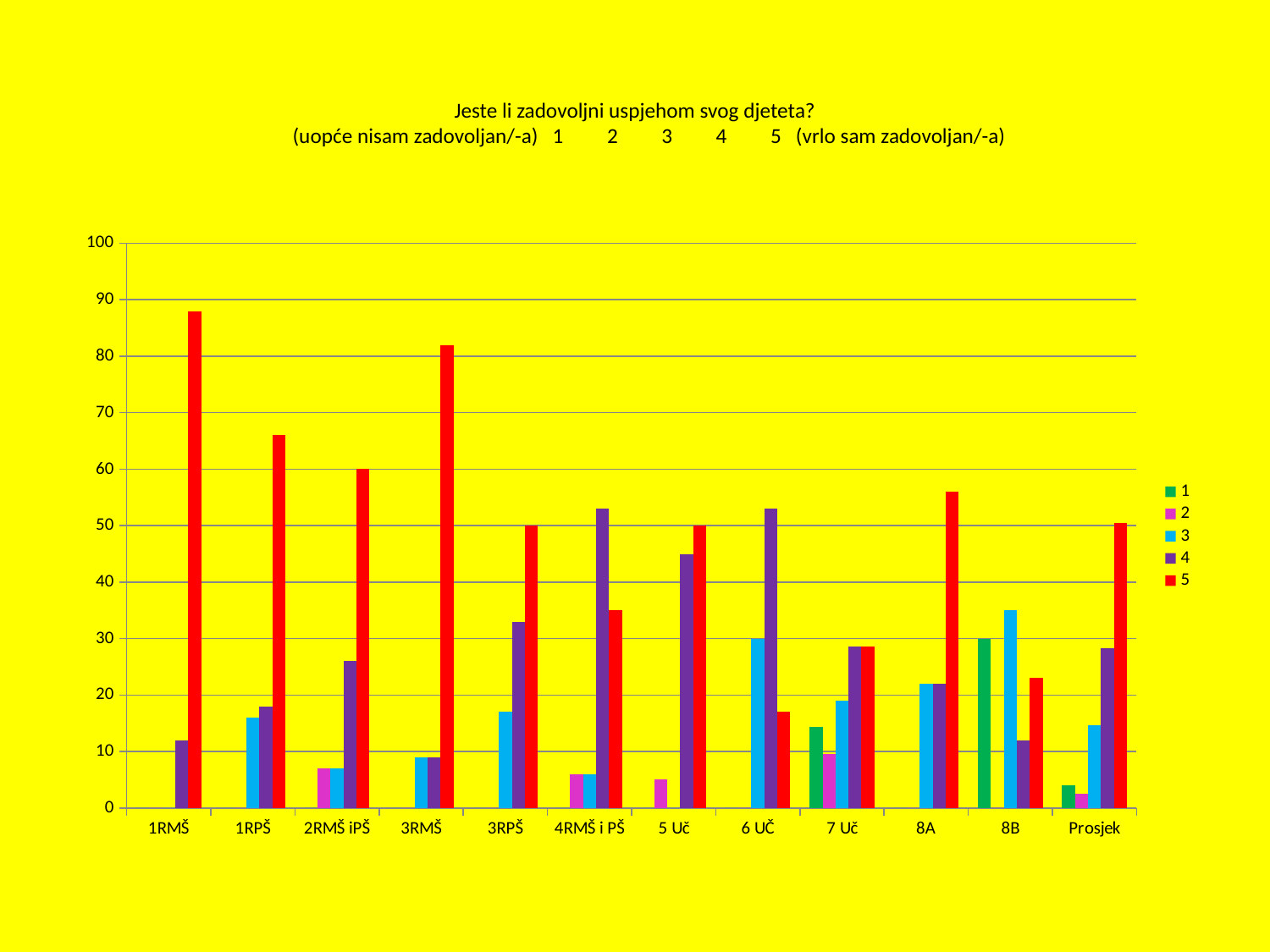
Which category has the highest value for series 3? 8B Is the value for series 5 in 1RMŠ greater or less than 80? greater Is the value for series 4 in 5 Uč greater or less than 40? greater Which category has the highest value for series 5? 1RMŠ How many categories are shown along the x axis? 12 What is the title of the chart? Jeste li zadovoljni uspjehom svog djeteta? How many series does the legend list? 5 In 6 UČ, which is larger: the value for series 4 or the value for series 5? series 4 Which category has the lowest value for series 5? 6 UČ Is the value for series 5 in 6 UČ greater or less than 20? less What kind of chart is shown on the slide? bar chart